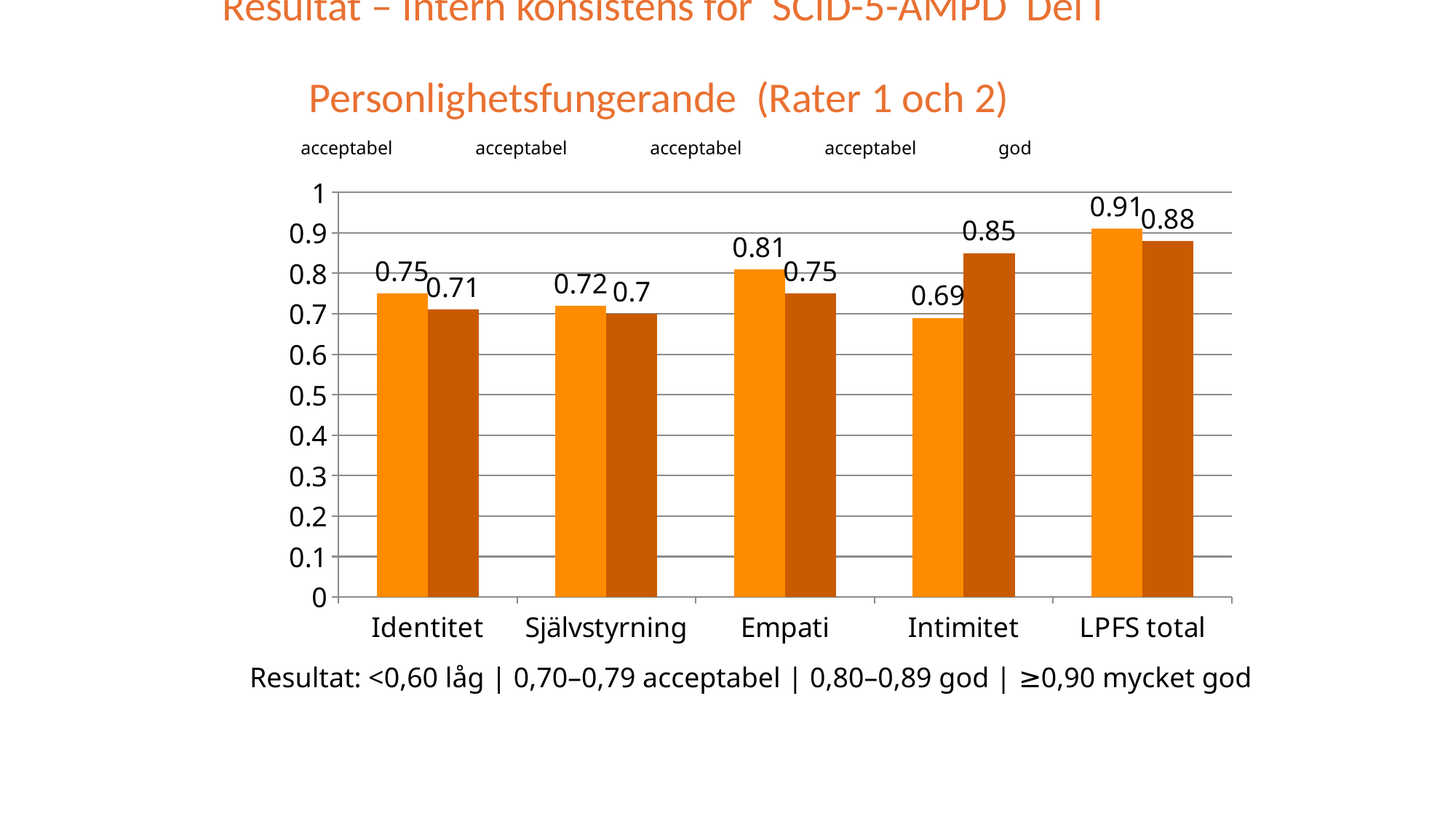
What is the difference between the lighter orange bars for LPFS total and Identitet? 0.16 Which category has the highest value among the lighter orange bars? LPFS total What is the value of the lighter orange bar for LPFS total? 0.91 What kind of chart is shown on the slide? bar chart What is the difference between the two bars for Intimitet? 0.16 What is the value of the darker orange bar for Intimitet? 0.85 How many categories are shown on the x axis? 5 For Empati, which bar is larger, the lighter orange or the darker orange one? the lighter orange bar What is the value of the darker orange bar for Självstyrning? 0.7 What is the title of the chart? Personlighetsfungerande (Rater 1 och 2) Which category has the lowest value among the lighter orange bars? Intimitet What is the value of the lighter orange bar for Identitet? 0.75